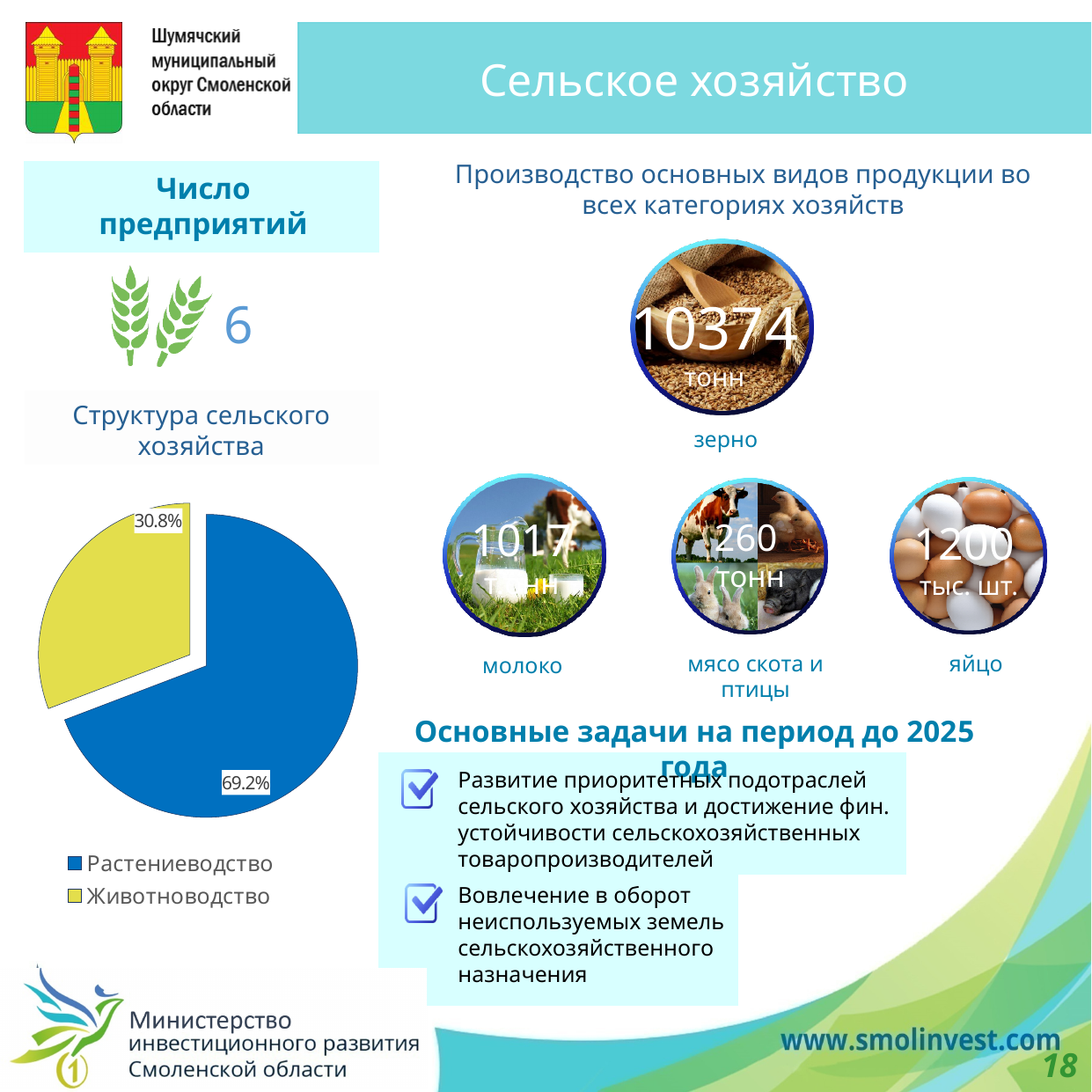
What colour is the Животноводство slice in the pie chart? yellow By how many percentage points does Растениеводство exceed Животноводство in the pie chart? 38.4 How many entries does the legend of the pie chart list? 2 What share of the pie chart does Животноводство have? 30.8% Which is larger in the pie chart, Растениеводство or Животноводство? Растениеводство How many slices does the pie chart have? 2 Which category has the largest slice in the pie chart? Растениеводство What colour is the Растениеводство slice in the pie chart? blue Which category has the smallest slice in the pie chart? Животноводство What is the total of the two slices shown in the pie chart? 100% What share of the pie chart does Растениеводство have? 69.2% What kind of chart is shown under "Структура сельского хозяйства"? pie chart